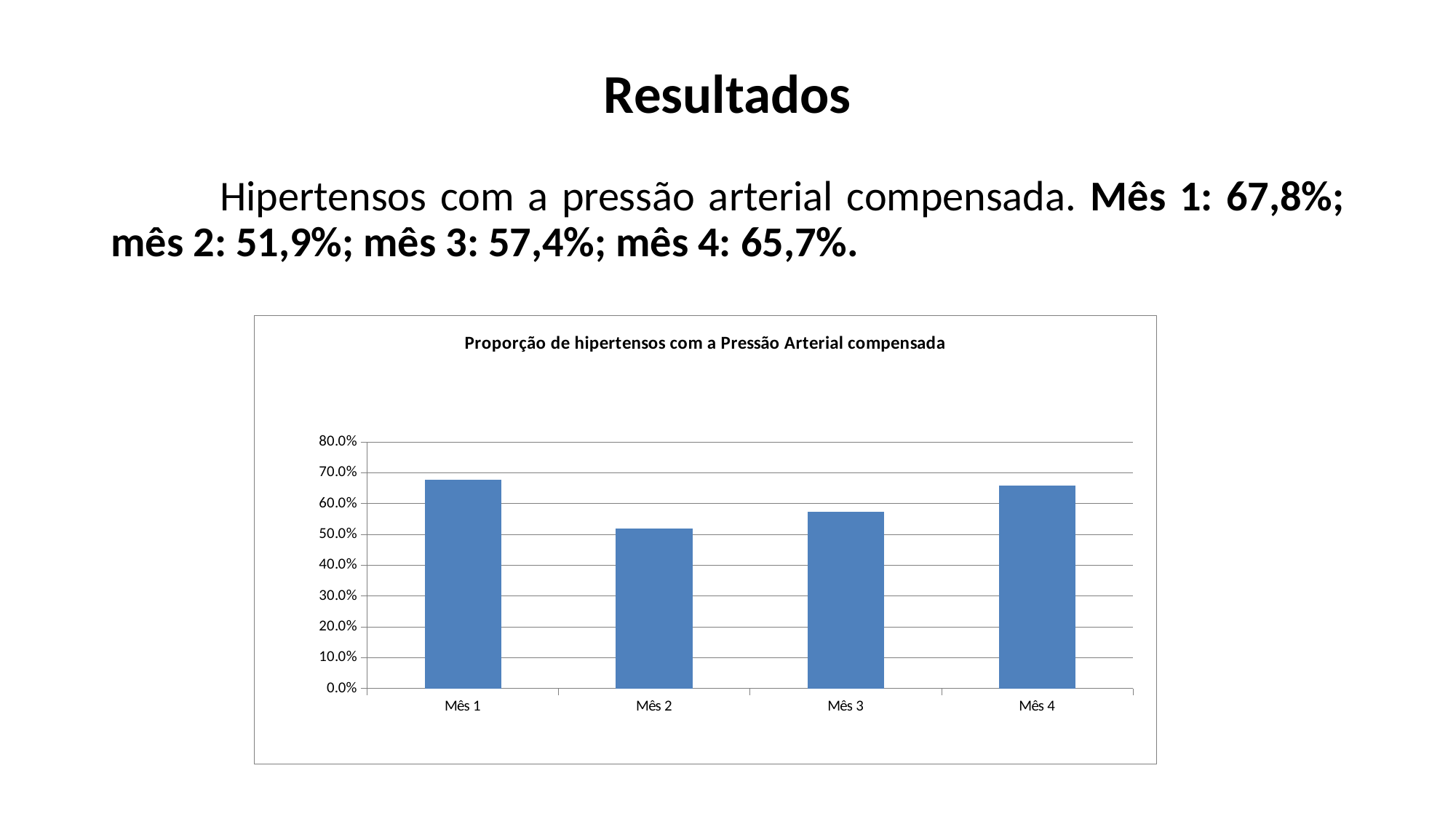
How many categories (months) are plotted in the chart? 4 What is the proportion of hypertensive patients with compensated blood pressure in Mês 4? 65,7% What is the title of the chart? Proporção de hipertensos com a Pressão Arterial compensada What is the proportion of hypertensive patients with compensated blood pressure in Mês 1? 67,8% Is the value for Mês 3 greater or less than 60.0%? less Do the values rise or fall from Mês 2 to Mês 4? rise Is the value for Mês 2 greater or less than 50.0%? greater Which month has the highest proportion of hypertensive patients with compensated blood pressure? Mês 1 Which is larger, the value for Mês 3 or the value for Mês 2? Mês 3 What type of chart is shown on the slide? bar chart What is the proportion of hypertensive patients with compensated blood pressure in Mês 2? 51,9% Which month has the lowest proportion of hypertensive patients with compensated blood pressure? Mês 2